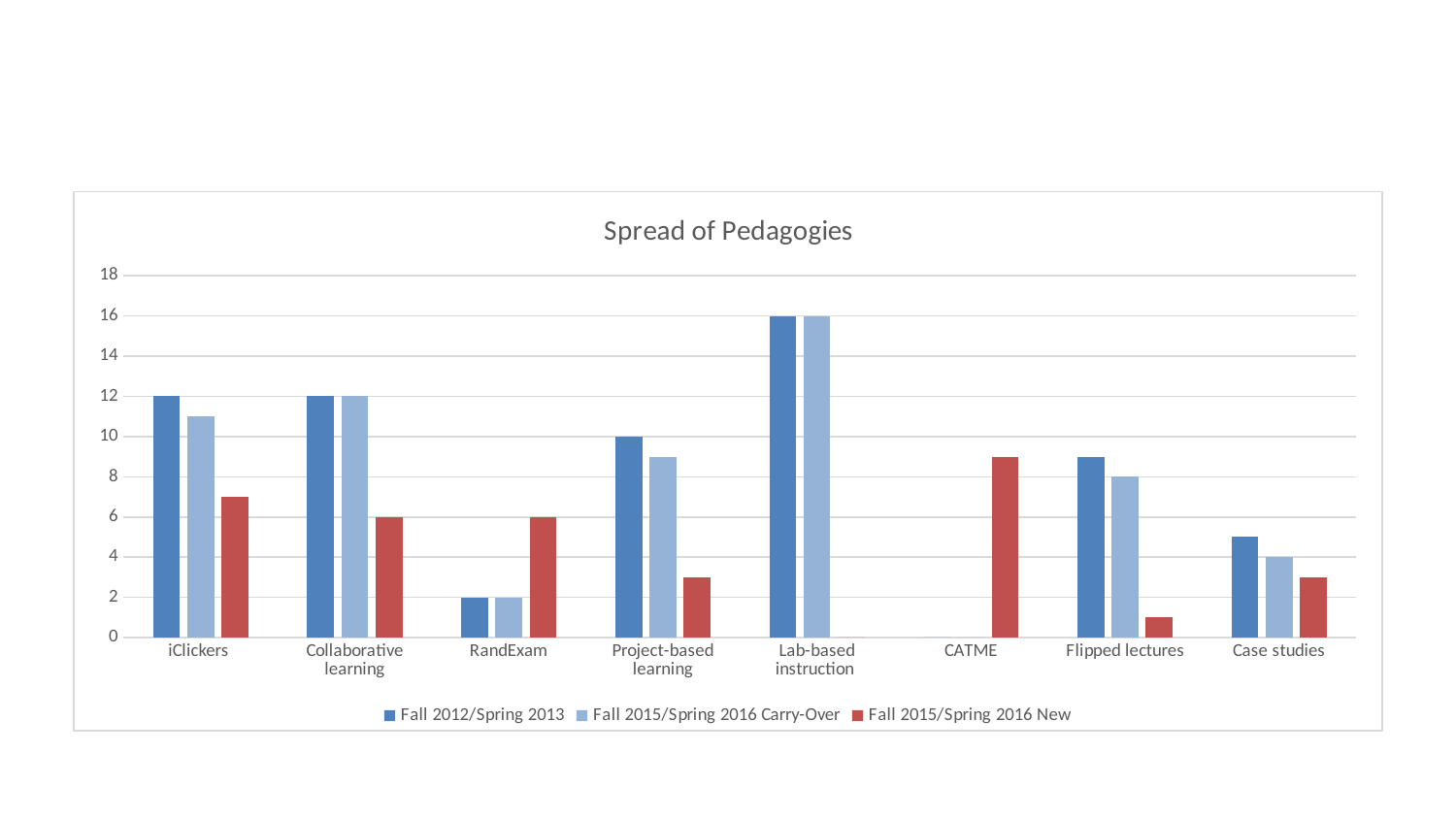
What is the Fall 2015/Spring 2016 New value for RandExam? 6 Is the Fall 2015/Spring 2016 New value for CATME greater or less than 8? greater Which category has the highest Fall 2012/Spring 2013 value? Lab-based instruction What is the difference between the Fall 2012/Spring 2013 value for Lab-based instruction and the Fall 2012/Spring 2013 value for RandExam? 14 Which category has the lowest Fall 2015/Spring 2016 New value among those with a visible red bar? Flipped lectures What is the Fall 2012/Spring 2013 value for Project-based learning? 10 What is the title of the chart? Spread of Pedagogies How many series does the legend list? 3 What kind of chart is shown on the slide? bar chart What is the Fall 2012/Spring 2013 value for Lab-based instruction? 16 What is the Fall 2015/Spring 2016 Carry-Over value for Collaborative learning? 12 How many pedagogy categories are shown on the x axis? 8